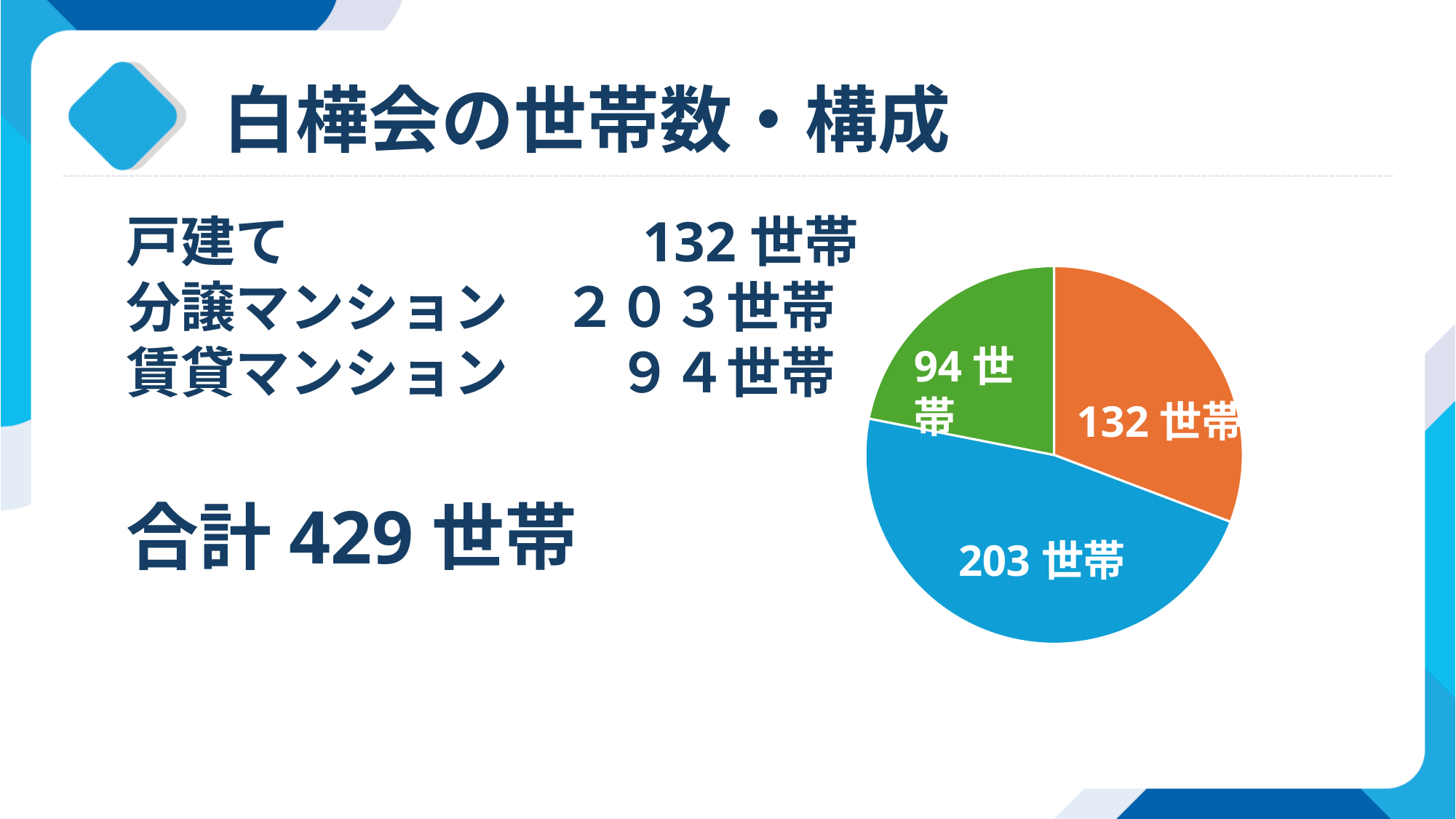
What kind of chart is shown on the slide? pie chart What is the difference between the orange slice (132 世帯) and the green slice (94 世帯)? 38 世帯 Which slice of the pie chart is the smallest? 94 世帯 (green) What value is shown on the orange slice of the pie chart? 132 世帯 Which is larger, the orange slice or the green slice? the orange slice (132 世帯) Which slice of the pie chart is the largest? 203 世帯 (blue) What is the title of the slide containing the pie chart? 白樺会の世帯数・構成 What value is shown on the green slice of the pie chart? 94 世帯 How many slices does the pie chart have? 3 What value is shown on the blue slice of the pie chart? 203 世帯 What is the total of all slices in the pie chart? 429 世帯 What is the difference between the blue slice (203 世帯) and the orange slice (132 世帯)? 71 世帯